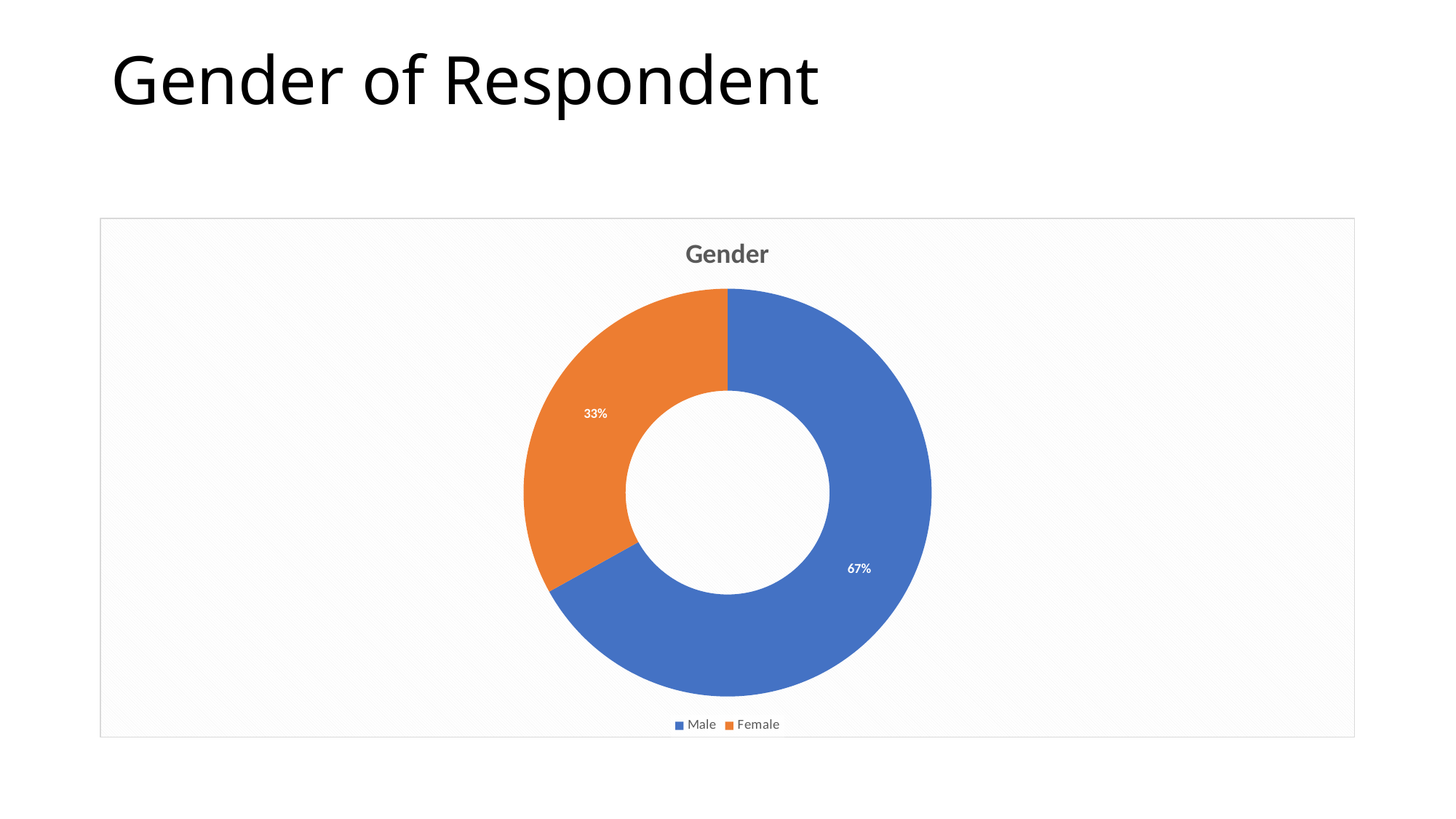
How many categories does the chart show? 2 What is the difference in percentage points between the Male and Female shares? 34 Which gender has the smallest share of respondents? Female Which gender has the largest share of respondents? Male What kind of chart is shown on the slide? Doughnut (pie) chart What colour represents Male in the chart? Blue What share of the pie does the Female slice represent? 33% Which is larger, the Male share or the Female share? Male What percentage of respondents are Male? 67% What percentage of respondents are Female? 33% What is the title of the chart? Gender